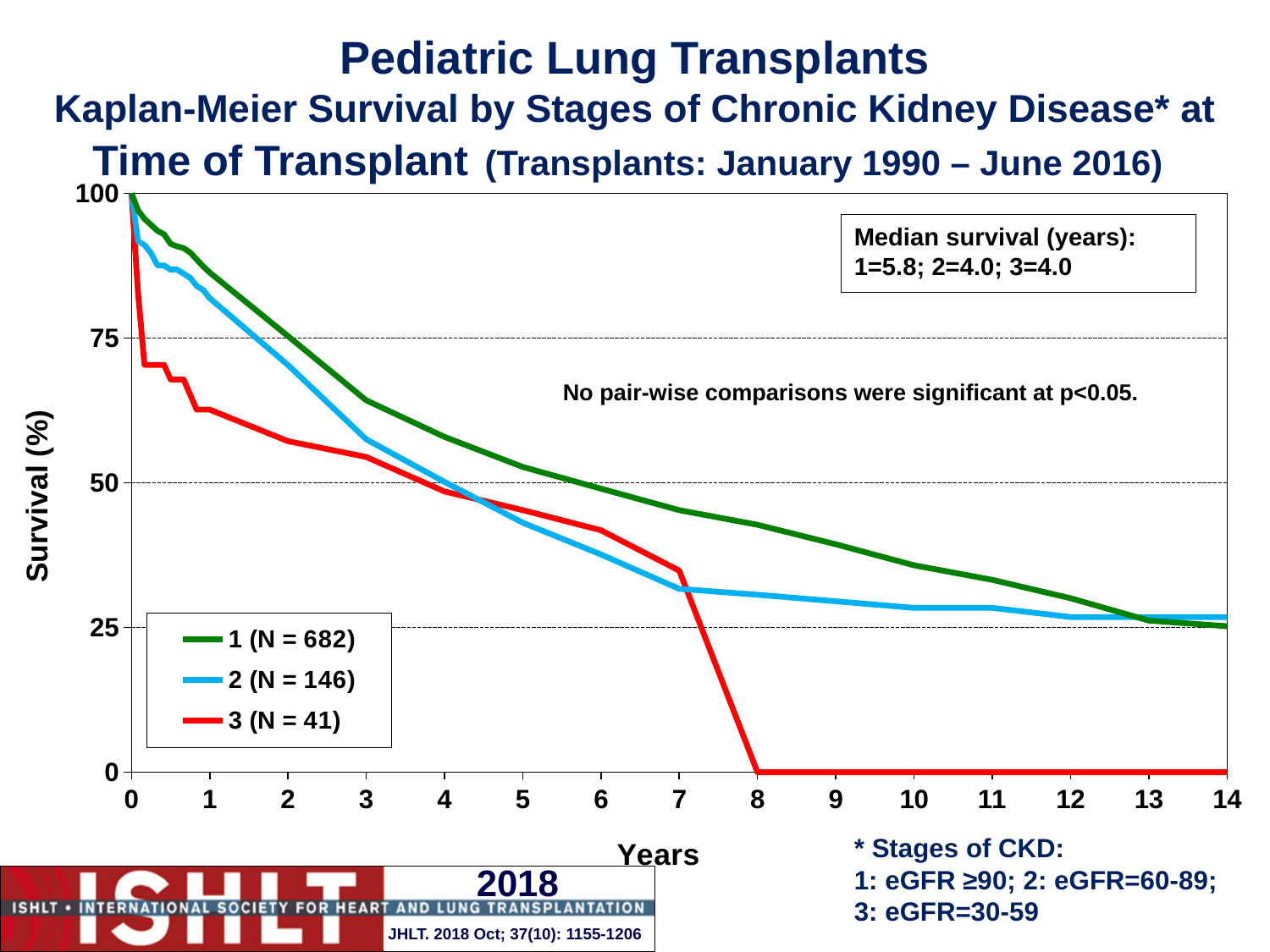
What kind of chart is shown on the slide? line chart Which CKD stage group has the highest median survival? 1 At 1 year, is survival for stage 3 greater or less than 75%? less What is the difference in median survival (years) between stage 1 and stage 2? 1.8 At 3 years, is survival for stage 1 greater or less than 50%? greater What is the N for the stage 2 group in the legend? 146 How many series does the legend list? 3 What is the median survival in years for CKD stage 1? 5.8 What is the label of the y axis? Survival (%) At 1 year, which group has higher survival, stage 1 or stage 3? stage 1 What is the median survival in years for CKD stage 3? 4.0 Which group has the smallest N in the legend? 3 (N = 41)